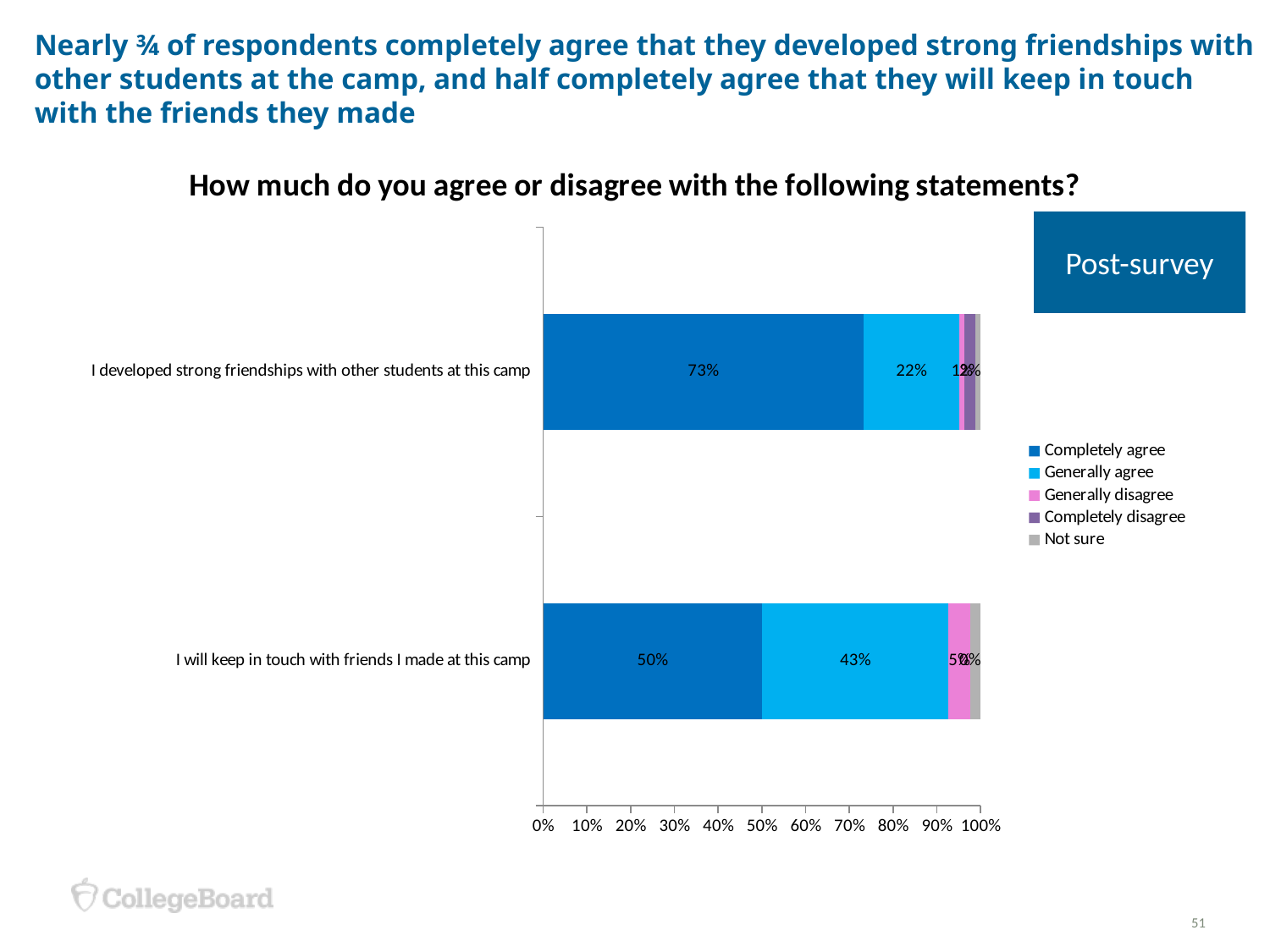
What percentage of respondents generally disagree with "I will keep in touch with friends I made at this camp"? 5% What type of chart is shown on the slide? Stacked bar chart Which statement has the higher Generally agree percentage? I will keep in touch with friends I made at this camp What percentage of respondents completely agree with "I developed strong friendships with other students at this camp"? 73% How many statements are shown in the chart? 2 Which response category is the largest for "I developed strong friendships with other students at this camp"? Completely agree What percentage of respondents completely agree with "I will keep in touch with friends I made at this camp"? 50% How many response categories does the legend list? 5 What is the difference between the Completely agree percentages for the two statements? 23% What percentage of respondents generally agree with "I will keep in touch with friends I made at this camp"? 43% Which statement has the higher Completely agree percentage? I developed strong friendships with other students at this camp What percentage of respondents generally agree with "I developed strong friendships with other students at this camp"? 22%